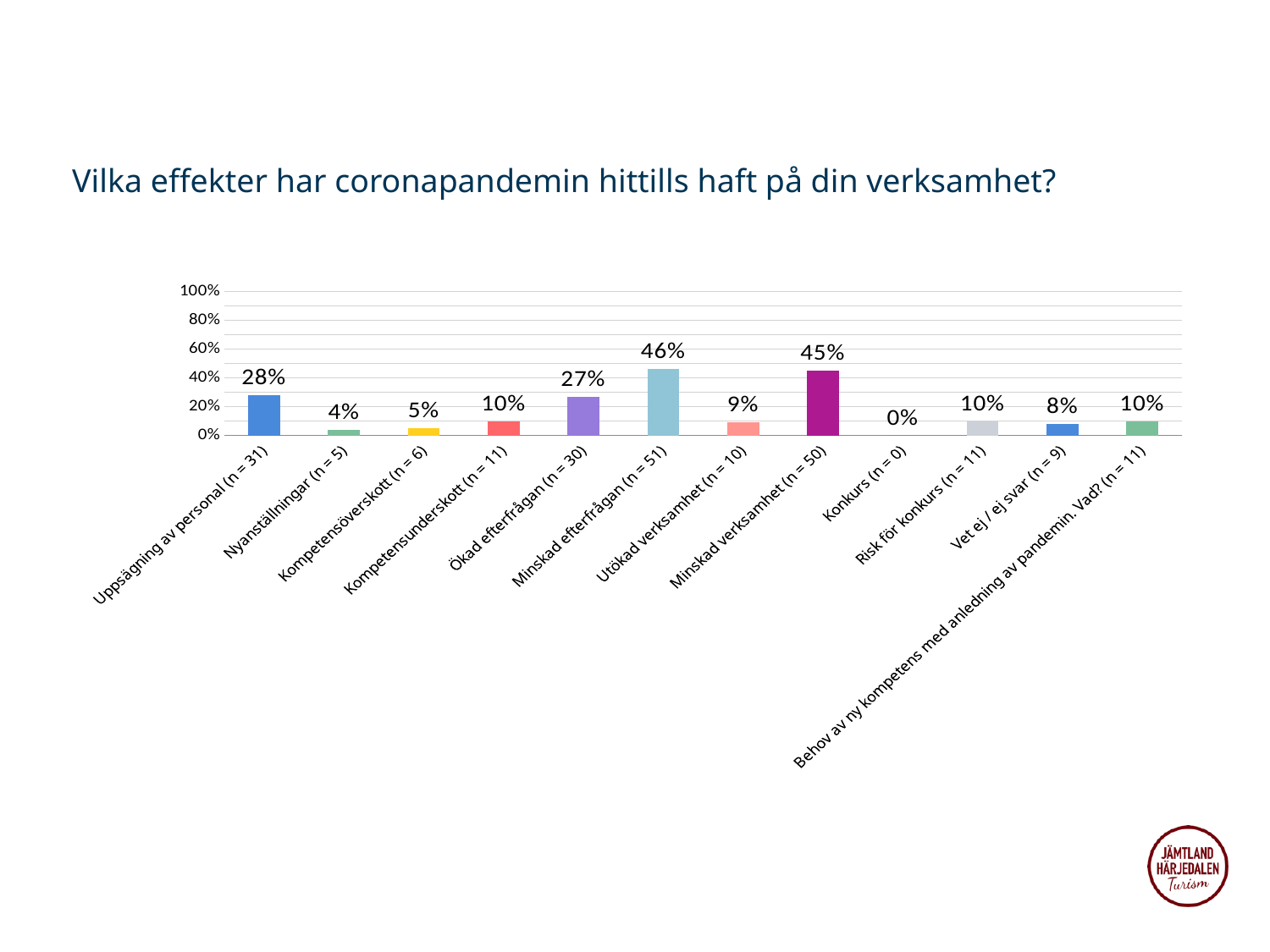
What is the value for Minskad verksamhet? 45% What is the value for Uppsägning av personal? 28% Which is larger, the value for Kompetensöverskott or the value for Kompetensunderskott? Kompetensunderskott How many categories are shown in the chart? 12 What is the value for Vet ej / ej svar? 8% What is the difference between the values for Uppsägning av personal and Nyanställningar? 24% What is the difference between the values for Minskad efterfrågan and Minskad verksamhet? 1% What is the title of the slide? Vilka effekter har coronapandemin hittills haft på din verksamhet? Which category has the highest value? Minskad efterfrågan What kind of chart is shown on the slide? Bar chart Which category has the lowest value? Konkurs What is the value for Ökad efterfrågan? 27%